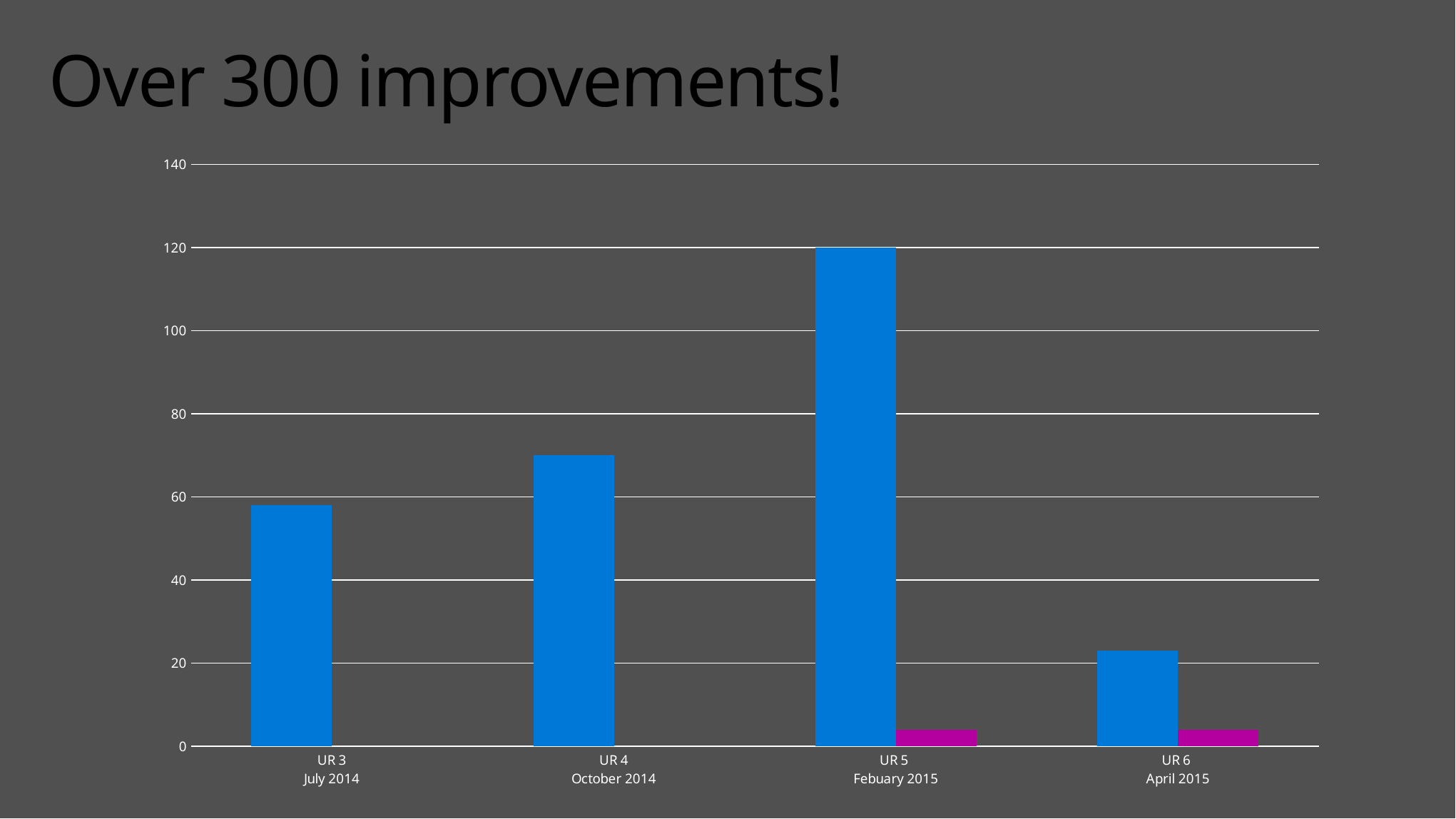
Is the value of the blue bar for UR 5 greater or less than 100? greater How many categories are shown on the x axis? 4 Is the value of the blue bar for UR 4 greater or less than 60? greater Which category has the tallest blue bar? UR 5 Which categories have a magenta bar in addition to the blue bar? UR 5 and UR 6 What is the title of the slide? Over 300 improvements! Which category has the shortest blue bar? UR 6 Is the value of the blue bar for UR 6 greater or less than 20? greater What kind of chart is shown on the slide? bar chart What is the value of the blue bar for UR 5? 120 Which has a larger blue bar, UR 3 or UR 4? UR 4